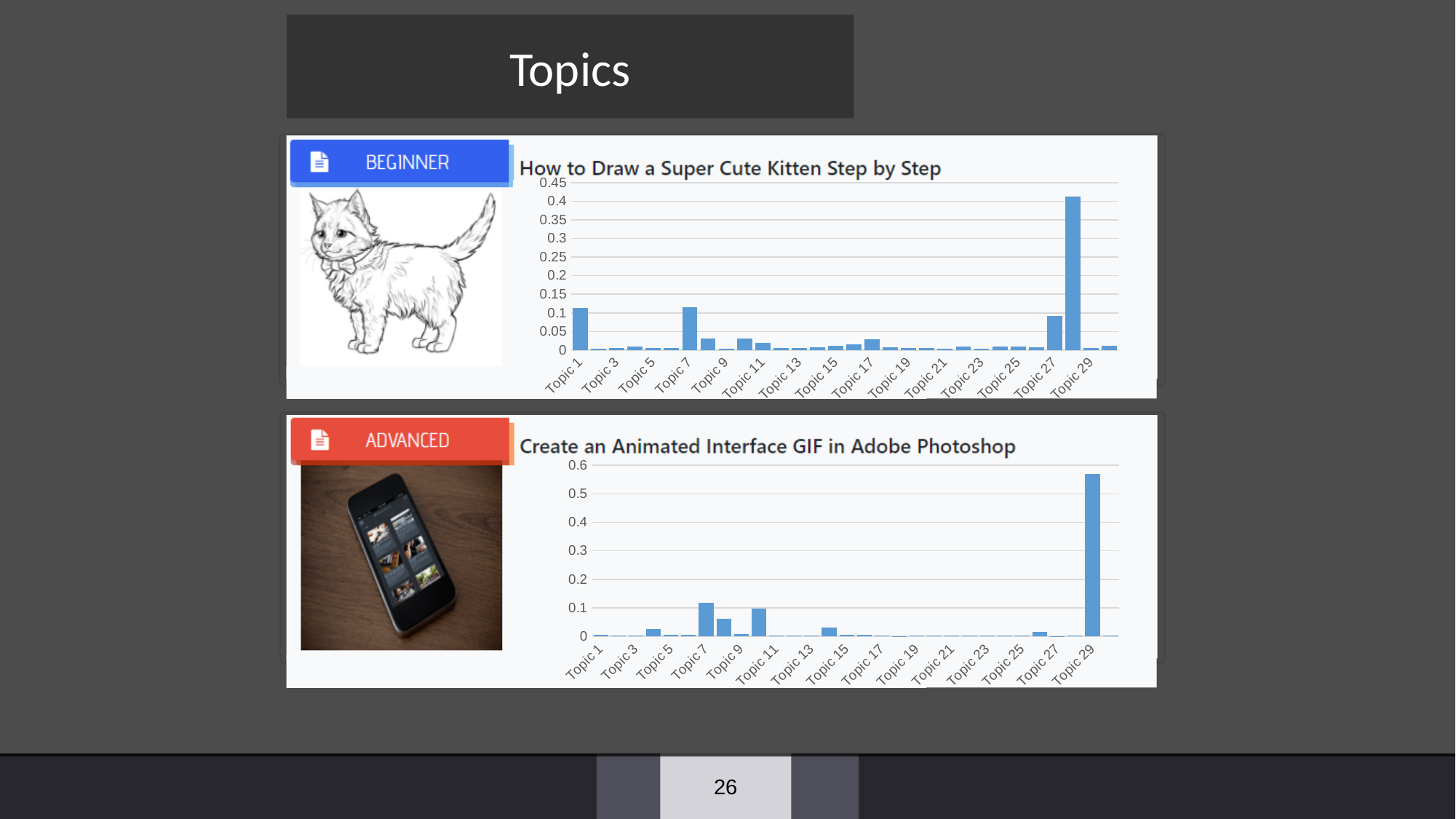
In the "Create an Animated Interface GIF in Adobe Photoshop" chart, is the value for Topic 7 greater or less than 0.2? less In the "How to Draw a Super Cute Kitten Step by Step" chart, which is larger, the value for Topic 29 or the value for Topic 1? Topic 1 In the "Create an Animated Interface GIF in Adobe Photoshop" chart, which topic has the highest value? Topic 29 In the "Create an Animated Interface GIF in Adobe Photoshop" chart, which is larger, the value for Topic 7 or the value for Topic 5? Topic 7 In the "How to Draw a Super Cute Kitten Step by Step" chart, is the value for Topic 29 greater or less than 0.35? less What kind of chart is shown under the title "How to Draw a Super Cute Kitten Step by Step"? bar chart In the "How to Draw a Super Cute Kitten Step by Step" chart, is the value for Topic 1 greater or less than 0.15? less Which difficulty label appears next to the "How to Draw a Super Cute Kitten Step by Step" chart? BEGINNER What is the highest value shown on the y axis of the "Create an Animated Interface GIF in Adobe Photoshop" chart? 0.6 In the "How to Draw a Super Cute Kitten Step by Step" chart, which is larger, the value for Topic 7 or the value for Topic 9? Topic 7 In the "How to Draw a Super Cute Kitten Step by Step" chart, which topic has the highest value? Topic 28